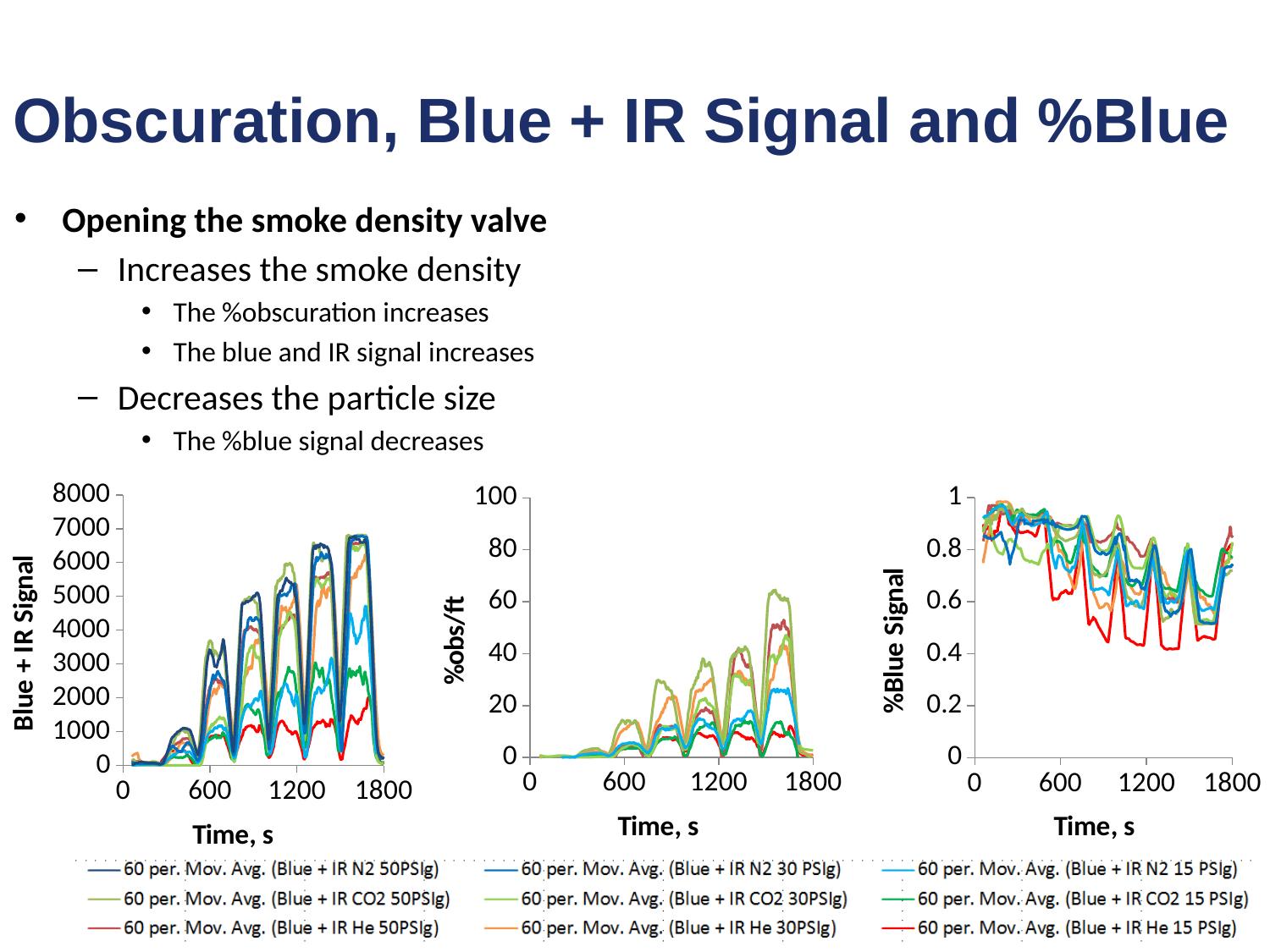
In the right chart (%Blue Signal), do the values generally rise or fall as time increases along the x axis? fall In the right chart (%Blue Signal), is the lowest value of the red 'Blue + IR He 15 PSIg' series greater or less than 0.5? less In the left chart (Blue + IR Signal), is the peak value of the red 'Blue + IR He 15 PSIg' series greater or less than 3000? less What is the x-axis title shared by the three charts? Time, s In the middle chart (%obs/ft), do the peak values generally rise or fall as time increases along the x axis? rise In the left chart (Blue + IR Signal), is the peak value of the dark blue 'Blue + IR N2 50PSIg' series greater or less than 6000? greater What kind of chart is the left chart with the y axis labelled 'Blue + IR Signal'? line chart How many charts are shown on the slide? 3 What is the y-axis title of the middle chart? %obs/ft How many series does the legend at the bottom of the slide list? 9